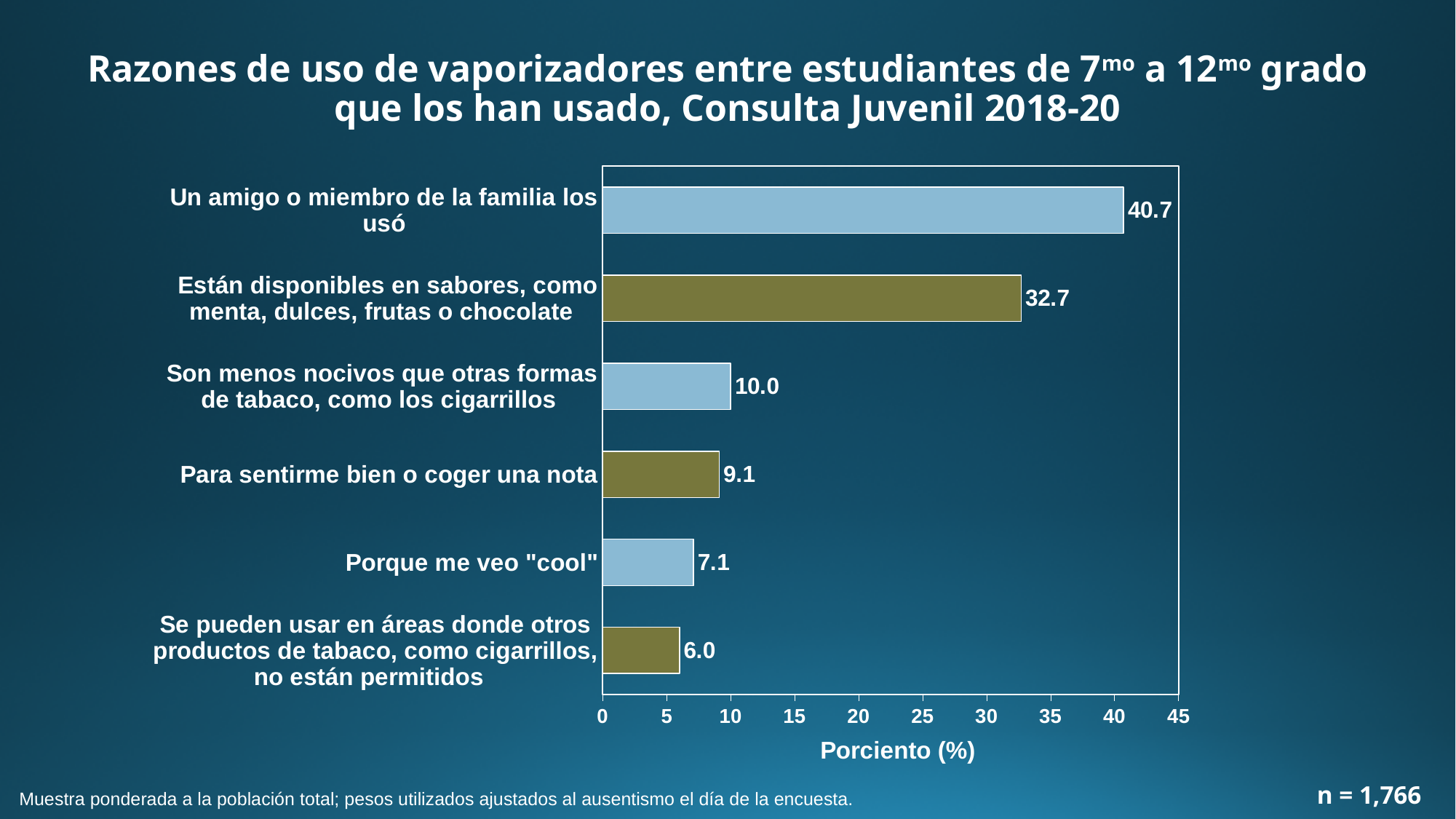
How many reasons (categories) are shown in the chart? 6 What kind of chart is shown on the slide? bar chart Which reason has the highest value? Un amigo o miembro de la familia los usó Which is larger: the value for "Son menos nocivos que otras formas de tabaco, como los cigarrillos" or for "Para sentirme bien o coger una nota"? Son menos nocivos que otras formas de tabaco, como los cigarrillos What is the label of the x axis? Porciento (%) What is the value for "Un amigo o miembro de la familia los usó"? 40.7 What is the value for "Están disponibles en sabores, como menta, dulces, frutas o chocolate"? 32.7 What is the difference between the values for "Un amigo o miembro de la familia los usó" and "Están disponibles en sabores, como menta, dulces, frutas o chocolate"? 8.0 Which reason has the lowest value? Se pueden usar en áreas donde otros productos de tabaco, como cigarrillos, no están permitidos Is the value for "Están disponibles en sabores, como menta, dulces, frutas o chocolate" greater or less than 30? greater What is the sample size (n) shown on the slide? n = 1,766 What is the value for "Porque me veo "cool""? 7.1